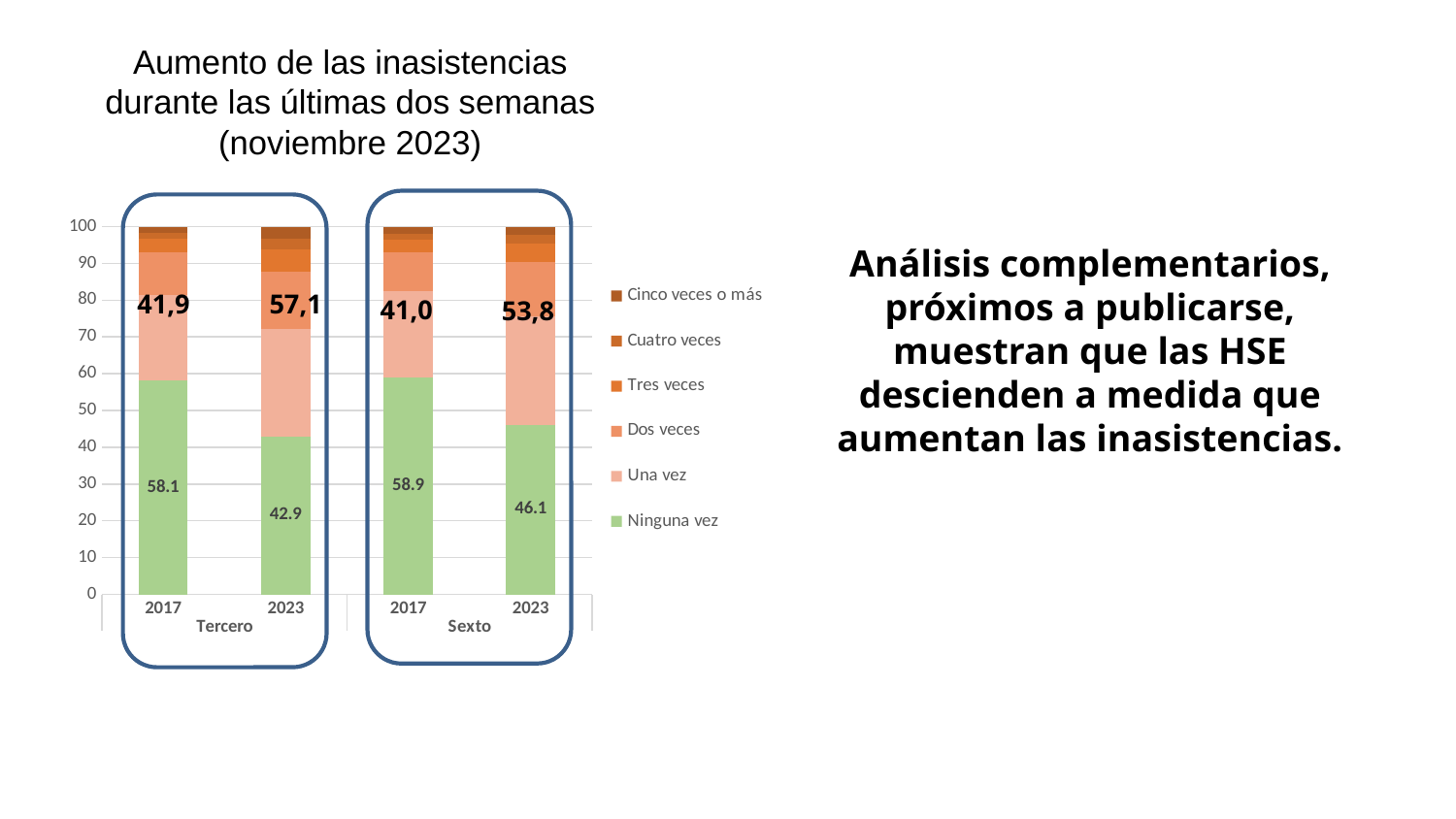
How many bars are plotted in the chart? 4 Which bar has the lowest "Ninguna vez" value? Tercero 2023 What is the value of the "Ninguna vez" segment for Tercero in 2017? 58.1 What is the difference between the "Ninguna vez" values for Tercero 2017 and Tercero 2023? 15.2 Does the "Ninguna vez" value for Sexto rise or fall from 2017 to 2023? Fall Is the "Ninguna vez" value for Tercero 2023 greater or less than 50? less What is the value of the "Ninguna vez" segment for Sexto in 2023? 46.1 What large bold value is printed on the Tercero 2023 bar above the green segment? 57,1 Which has a larger "Ninguna vez" value, Tercero 2023 or Sexto 2023? Sexto 2023 How many series does the legend list? 6 Which bar has the highest "Ninguna vez" value? Sexto 2017 What kind of chart is shown on the slide? Stacked bar chart